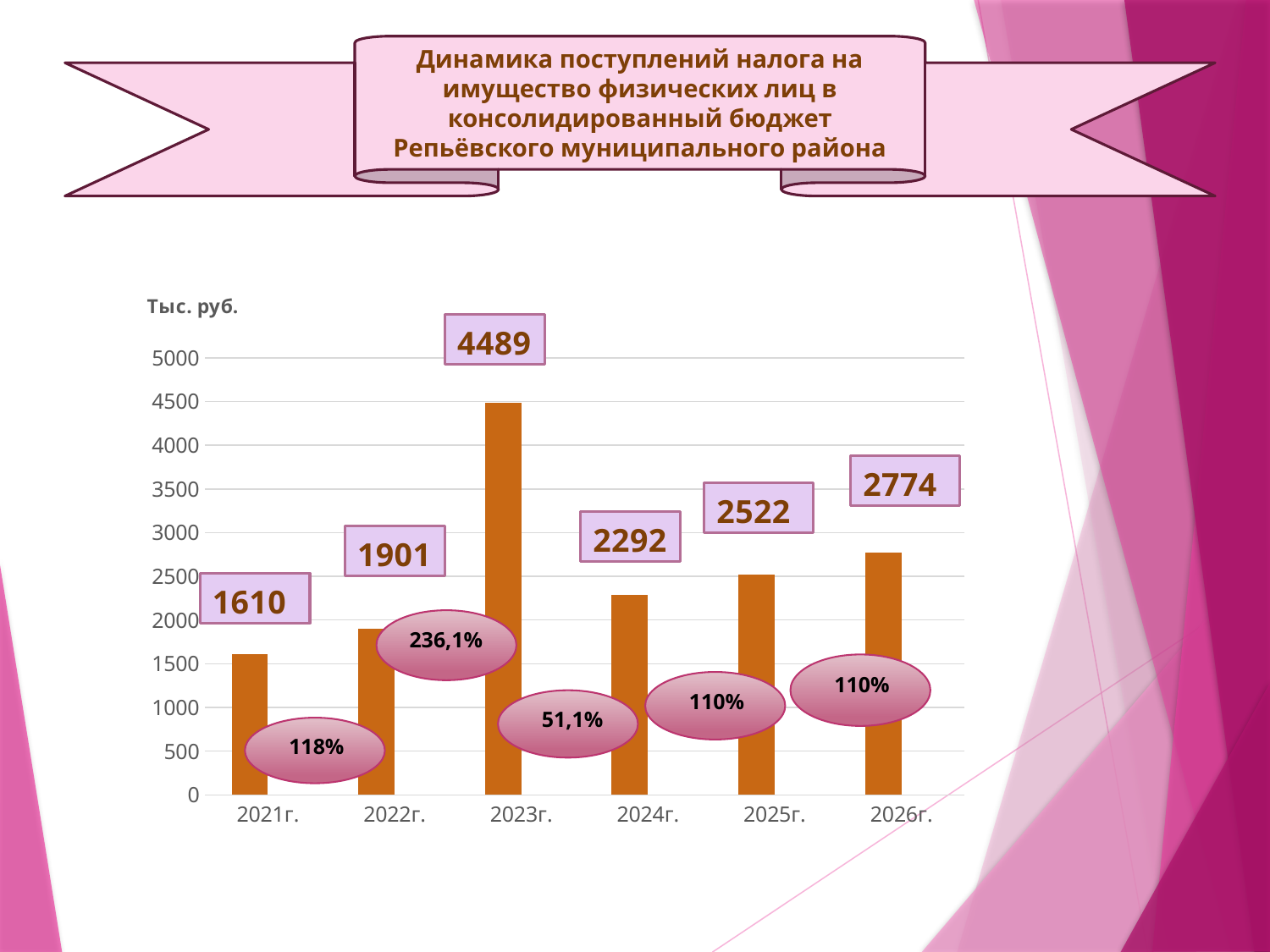
Which year has the lowest value? 2021г. Which is larger, the value for 2022г. or the value for 2024г.? 2024г. What unit label is shown above the vertical axis? Тыс. руб. What is the value for 2021г.? 1610 Is the value for 2025г. greater or less than 2000? greater What is the difference between the values for 2023г. and 2024г.? 2197 What kind of chart is shown on the slide? bar chart Which year has the highest value? 2023г. What is the difference between the values for 2026г. and 2025г.? 252 How many years are shown on the x axis? 6 What is the value for 2023г.? 4489 What is the value for 2026г.? 2774